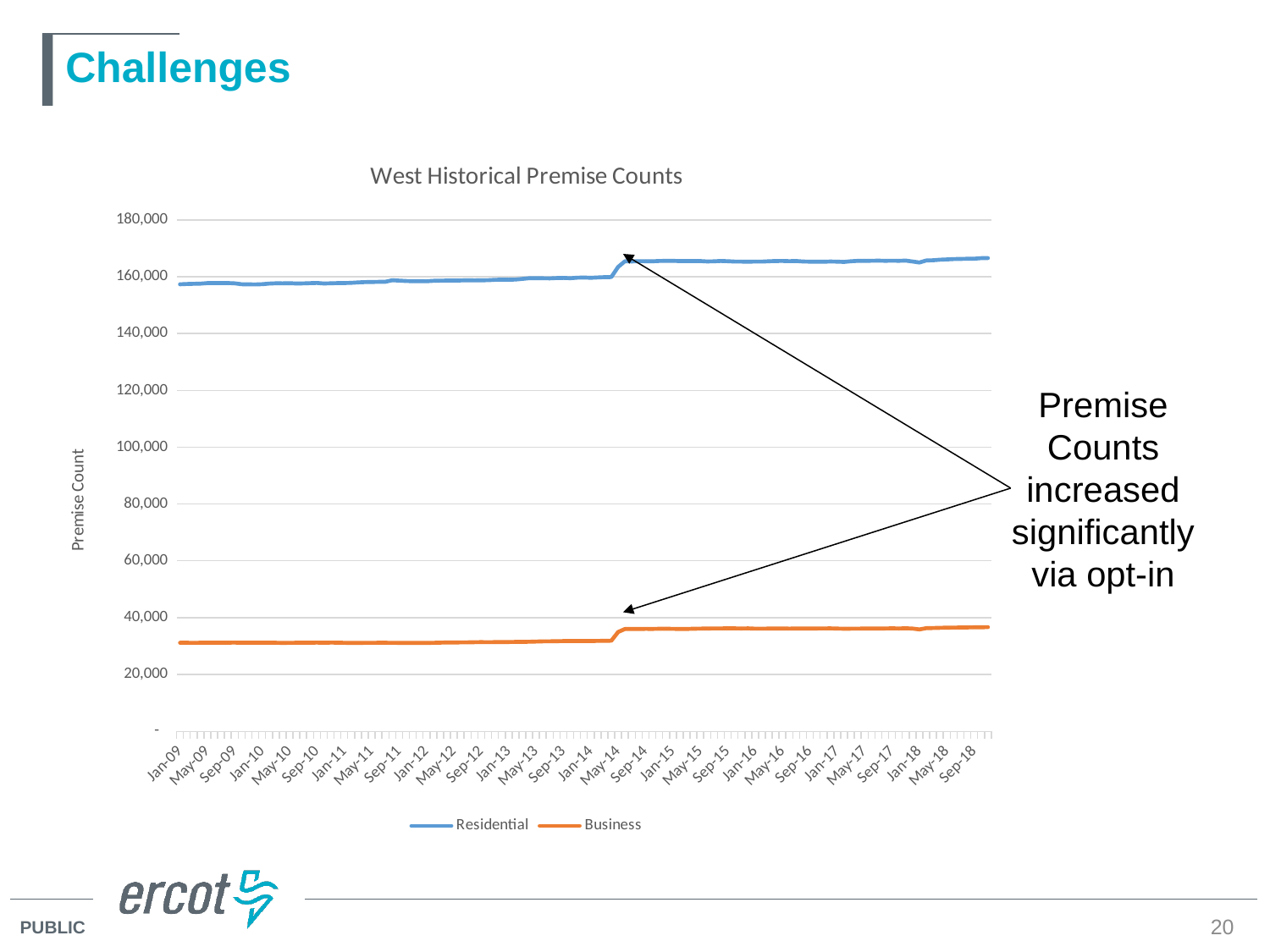
How many series does the legend of the chart list? 2 Which series has the higher values throughout the chart, Residential or Business? Residential Is the Business value in Sep-18 greater or less than 20,000? greater What is the label on the vertical axis of the chart? Premise Count What is the title of the chart? West Historical Premise Counts Is the Residential value in Jan-09 greater or less than 160,000? less Is the Business value in Jan-09 greater or less than 40,000? less Do the Residential premise counts rise or fall overall from Jan-09 to Sep-18? rise What kind of chart is shown on the slide? Line chart Do the Business premise counts rise or fall overall from Jan-09 to Sep-18? rise